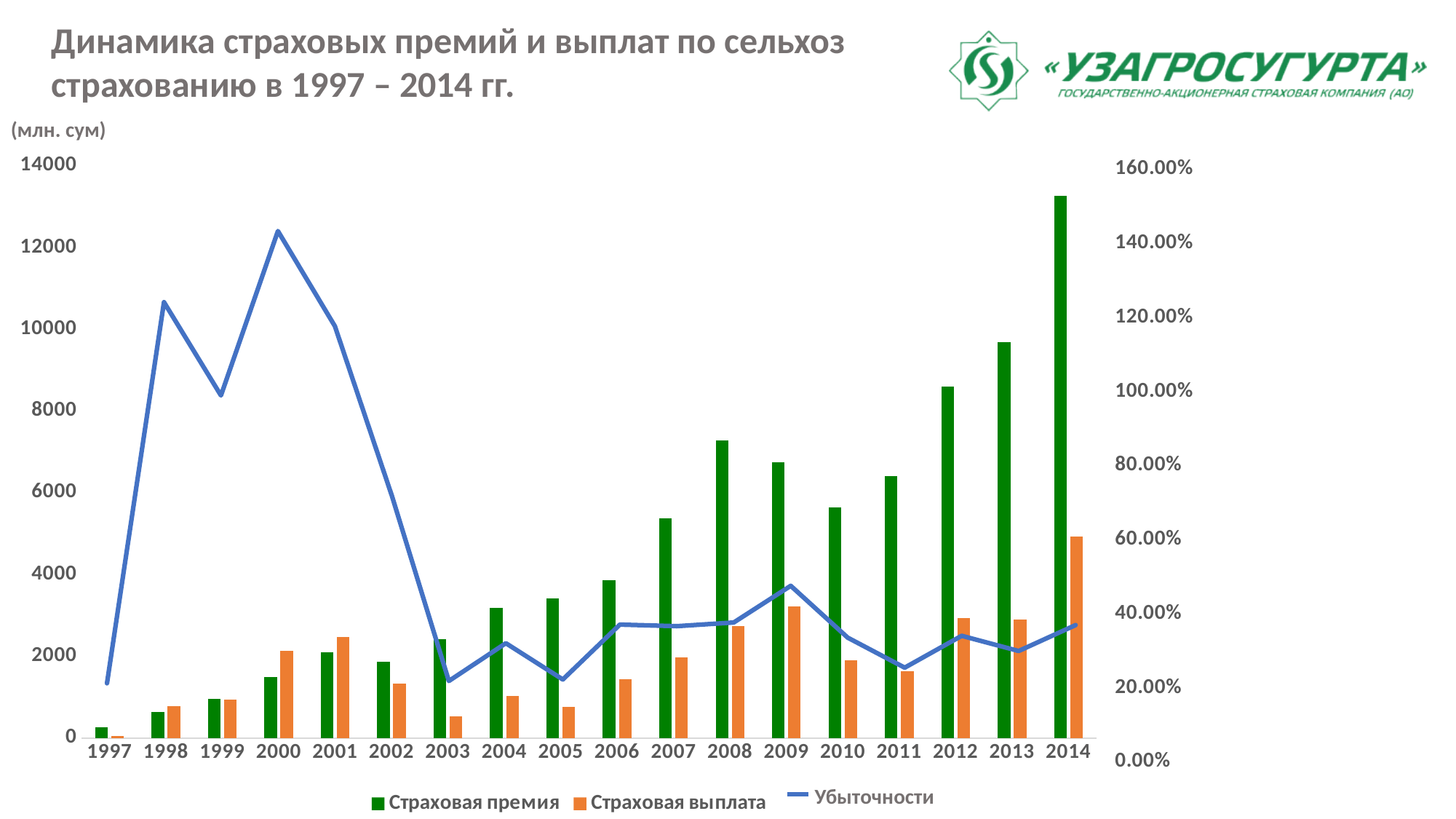
Is the Страховая премия value for 2014 greater or less than 12000? greater How many series does the legend list? 3 In which year does the Убыточности line reach its peak? 2000 Which year has the larger Страховая премия, 2008 or 2009? 2008 In which year is the Страховая премия (green bar) highest? 2014 In which year is the Страховая выплата (orange bar) highest? 2014 What kind of chart is shown on the slide? A combined bar and line chart How many years are shown along the x axis? 18 Does the Убыточности line rise or fall from 2001 to 2003? fall In which year is the Страховая премия (green bar) lowest? 1997 Is the Страховая выплата value for 2014 greater or less than 4000? greater In 2001, which is larger: Страховая премия or Страховая выплата? Страховая выплата